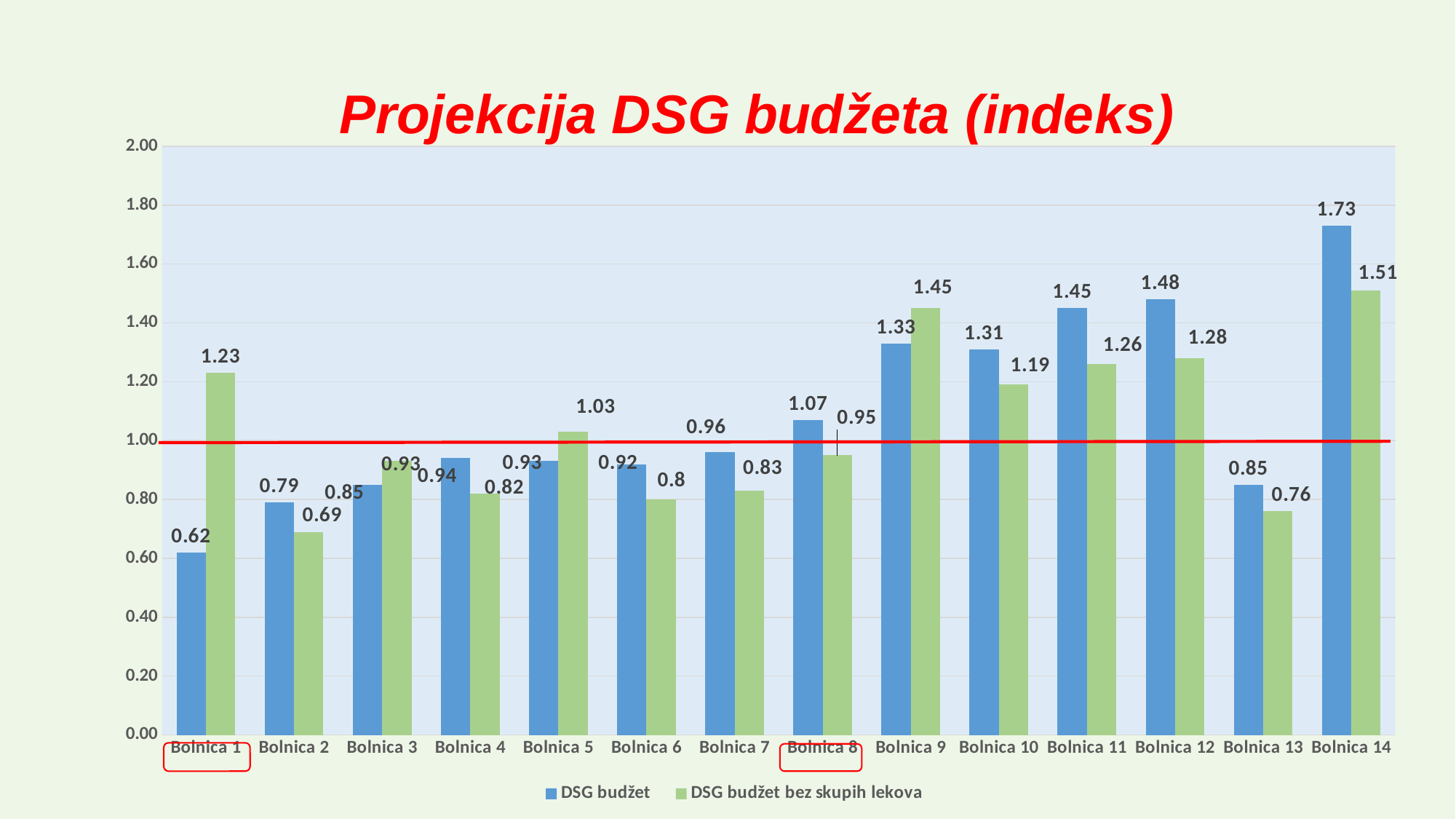
Which hospital has the lowest DSG budžet value? Bolnica 1 What is the DSG budžet value for Bolnica 8? 1.07 How many hospitals (categories) are shown on the x axis? 14 What is the difference between the DSG budžet and DSG budžet bez skupih lekova values for Bolnica 1? 0.61 What is the DSG budžet bez skupih lekova value for Bolnica 1? 1.23 For Bolnica 9, which is larger: DSG budžet or DSG budžet bez skupih lekova? DSG budžet bez skupih lekova Which hospital has the highest DSG budžet value? Bolnica 14 Which hospital has the lowest DSG budžet bez skupih lekova value? Bolnica 2 What kind of chart is shown on the slide? Bar chart What is the DSG budžet value for Bolnica 14? 1.73 What is the title of the chart? Projekcija DSG budžeta (indeks) How many series does the legend list? 2